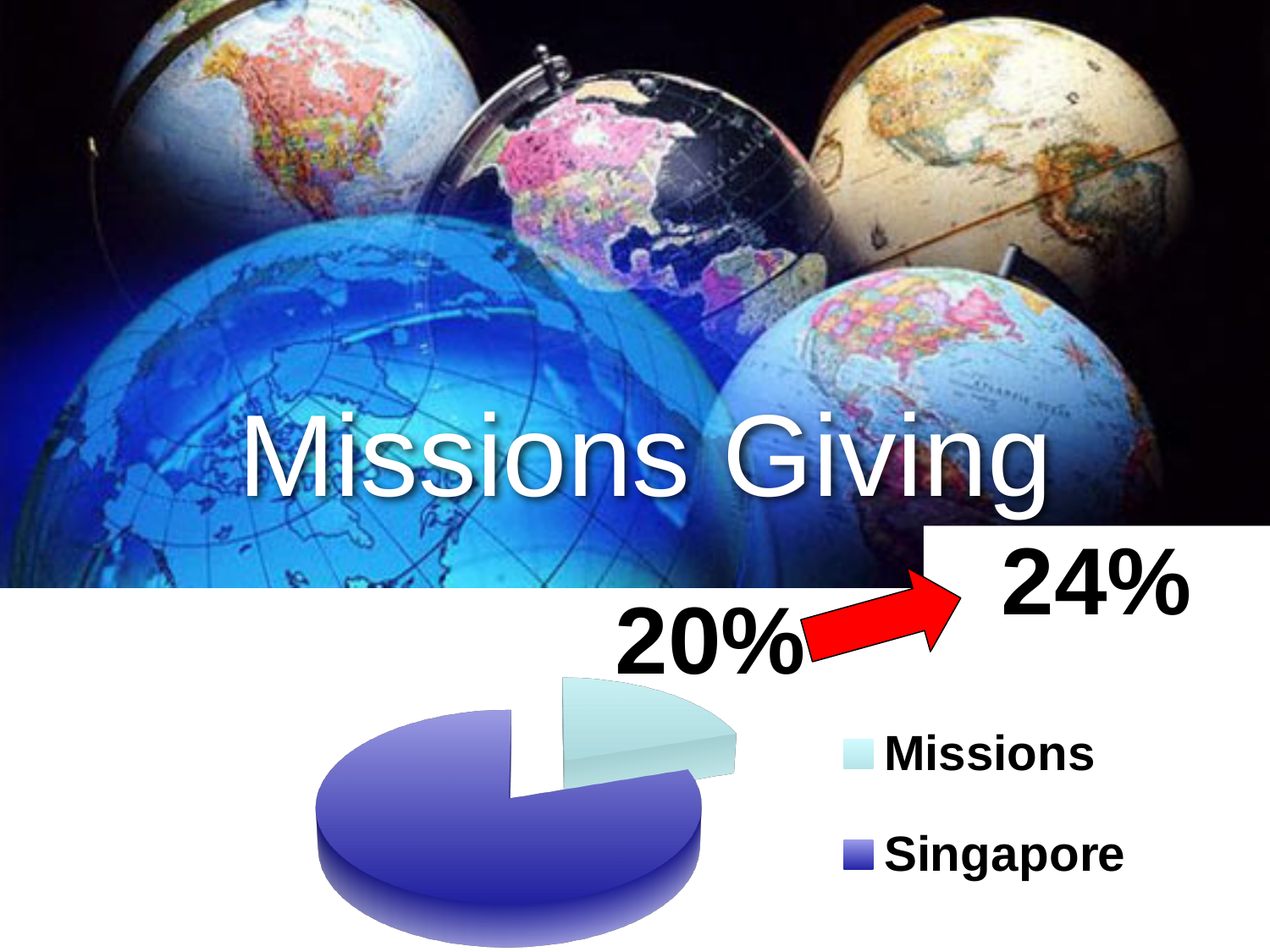
How many slices does the pie chart have? 2 Which category has the largest slice in the pie chart? Singapore What percentage is labelled on the Missions slice of the pie chart? 20% What kind of chart is shown on the slide? pie chart What percentage does the red arrow next to the pie chart point to? 24% Which category has the smallest slice in the pie chart? Missions How many entries does the legend of the pie chart list? 2 Which slice of the pie chart is larger, Missions or Singapore? Singapore Which legend entry in the pie chart is shown in light cyan? Missions What share of the pie does the Missions slice represent? 20% What is the title of the slide containing the pie chart? Missions Giving